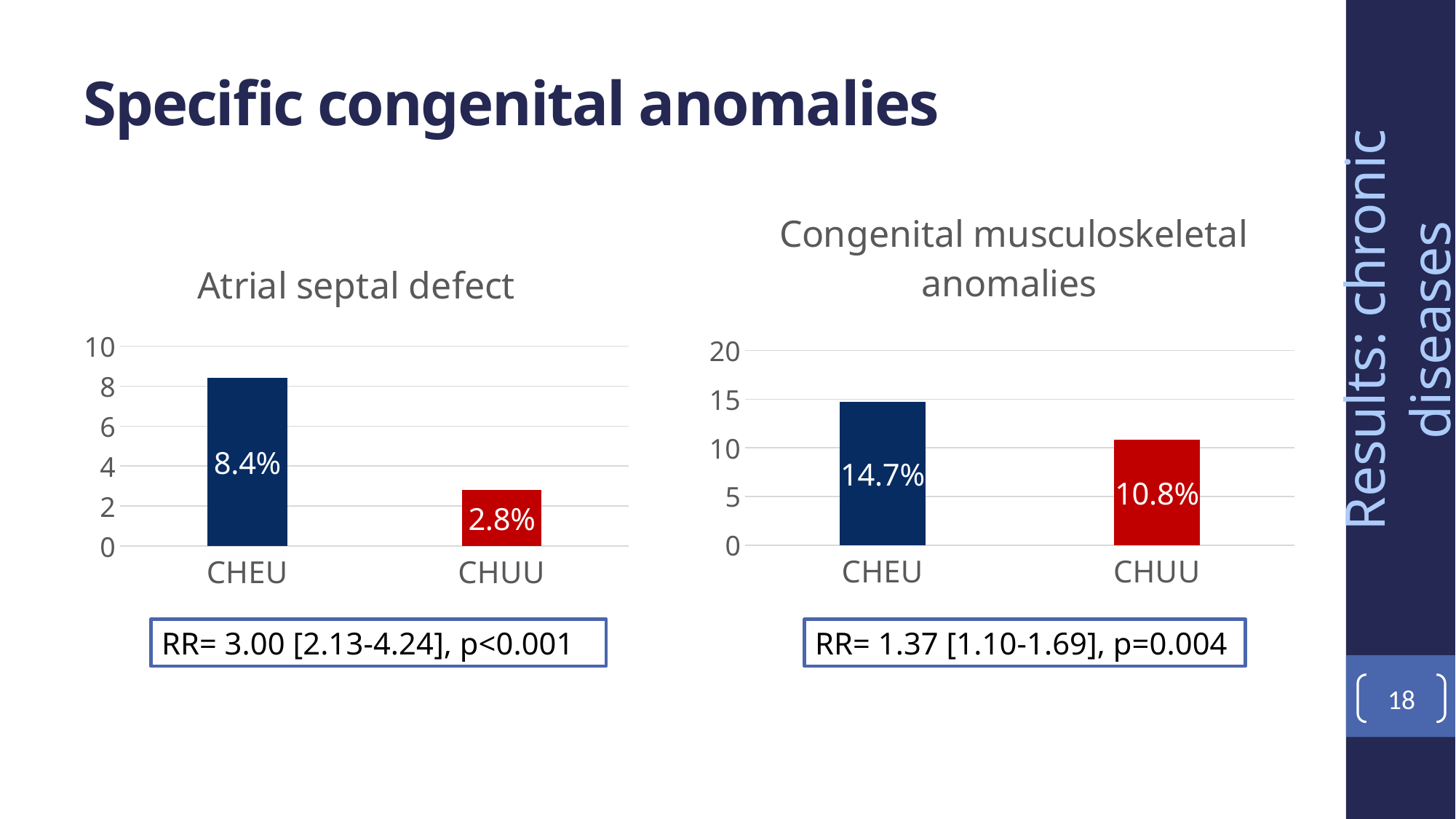
How many categories are shown in the Congenital musculoskeletal anomalies chart? 2 In the Atrial septal defect chart, which category has the highest value? CHEU In the Atrial septal defect chart, what is the value for CHUU? 2.8% In the Atrial septal defect chart, what is the difference between the CHEU and CHUU values? 5.6% In the Congenital musculoskeletal anomalies chart, which is larger, the value for CHEU or CHUU? CHEU In the Congenital musculoskeletal anomalies chart, what is the difference between the CHEU and CHUU values? 3.9% In the Atrial septal defect chart, is the value for CHEU greater or less than 6? greater What kind of chart is the Atrial septal defect chart? bar chart In the Congenital musculoskeletal anomalies chart, what is the value for CHEU? 14.7% In the Atrial septal defect chart, what is the value for CHEU? 8.4% In the Congenital musculoskeletal anomalies chart, what is the value for CHUU? 10.8% In the Congenital musculoskeletal anomalies chart, which category has the lowest value? CHUU